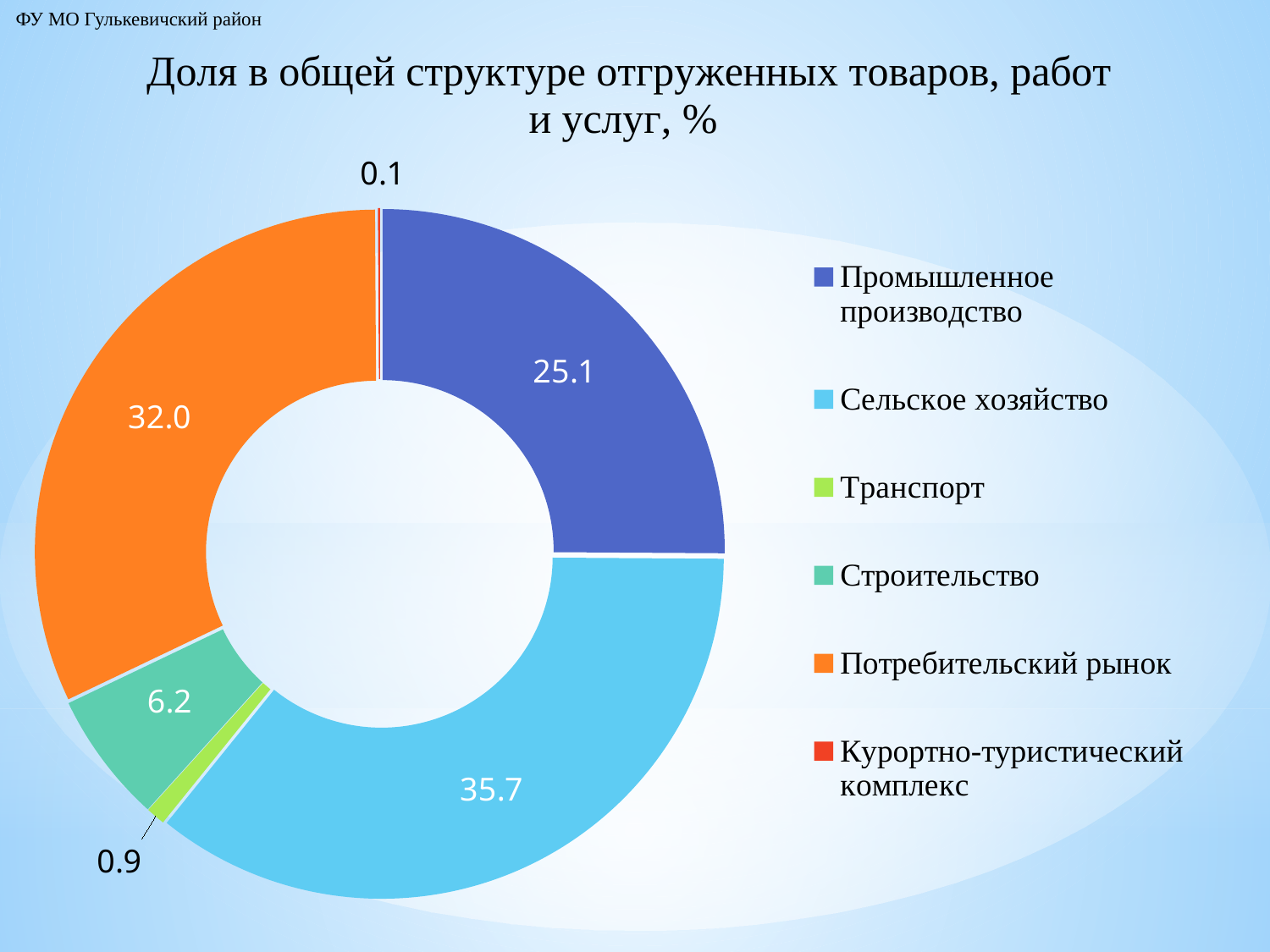
What kind of chart is shown on the slide? Doughnut (pie) chart How many categories does the legend list? 6 What is the value for Сельское хозяйство? 35.7 What is the title of the chart? Доля в общей структуре отгруженных товаров, работ и услуг, % Which category has the smallest share? Курортно-туристический комплекс What is the value for Промышленное производство? 25.1 Which category has the largest share? Сельское хозяйство Which is larger, the value for Потребительский рынок or Промышленное производство? Потребительский рынок What is the difference between the values for Сельское хозяйство and Потребительский рынок? 3.7 What is the value for Строительство? 6.2 What is the value for Потребительский рынок? 32.0 What is the value for Курортно-туристический комплекс? 0.1